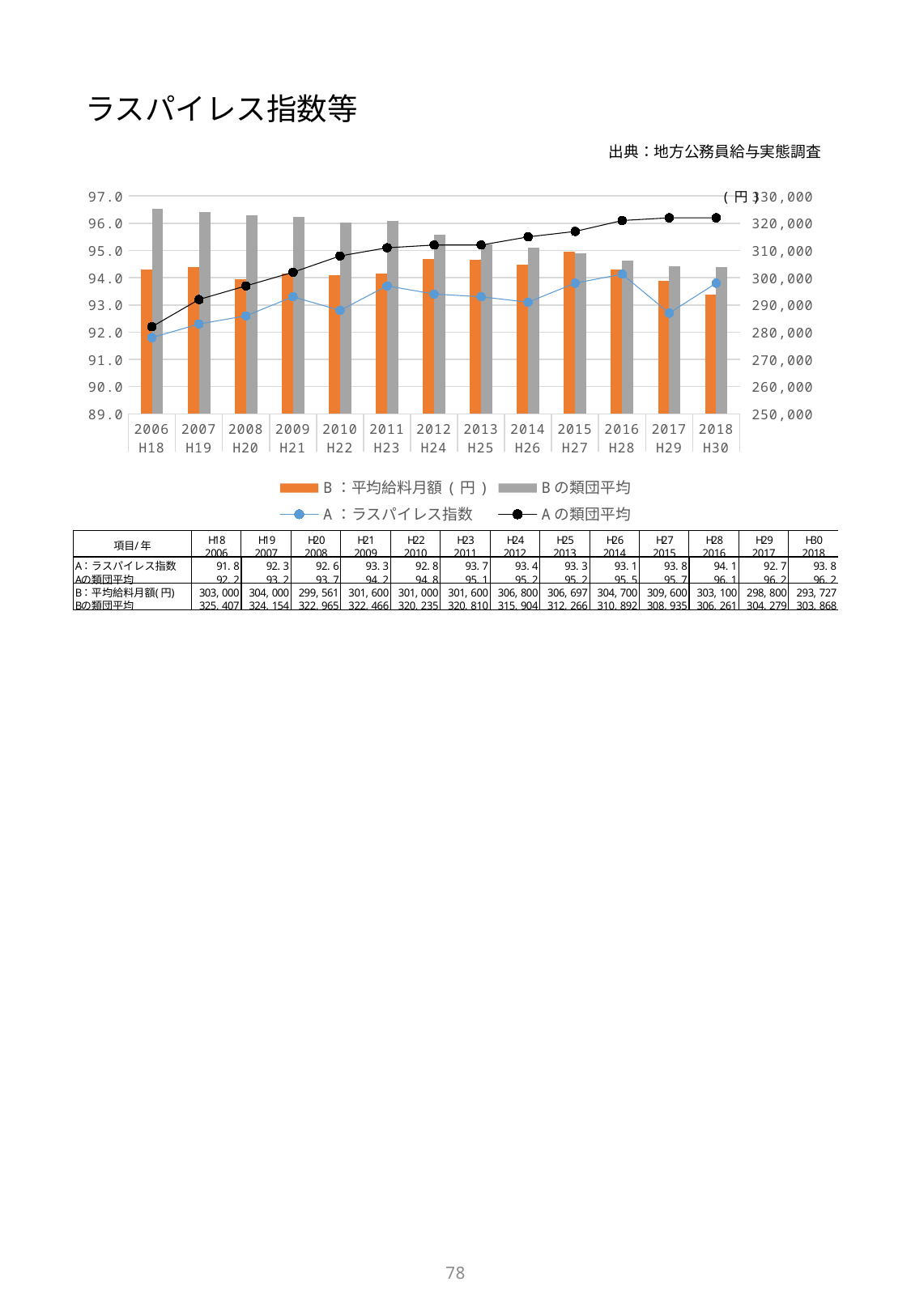
What is the value of A：ラスパイレス指数 for 2018 (H30)? 93.8 In which year is B：平均給料月額（円） lowest? 2018 (H30) Does Aの類団平均 generally rise or fall from 2006 to 2018? rise What is the difference between Bの類団平均 and B：平均給料月額（円） in 2006 (H18)? 22,407 What is the value of B：平均給料月額（円） for 2015 (H27)? 309,600 How many years are shown on the x axis of the chart? 13 What kind of chart is shown on the slide? Combination bar and line chart What is the difference between Aの類団平均 and A：ラスパイレス指数 in 2018 (H30)? 2.4 Is the value of Bの類団平均 for 2006 greater or less than 320,000? greater Which year has the larger B：平均給料月額（円）, 2007 or 2008? 2007 In which year is A：ラスパイレス指数 highest? 2016 (H28) How many series does the legend list? 4